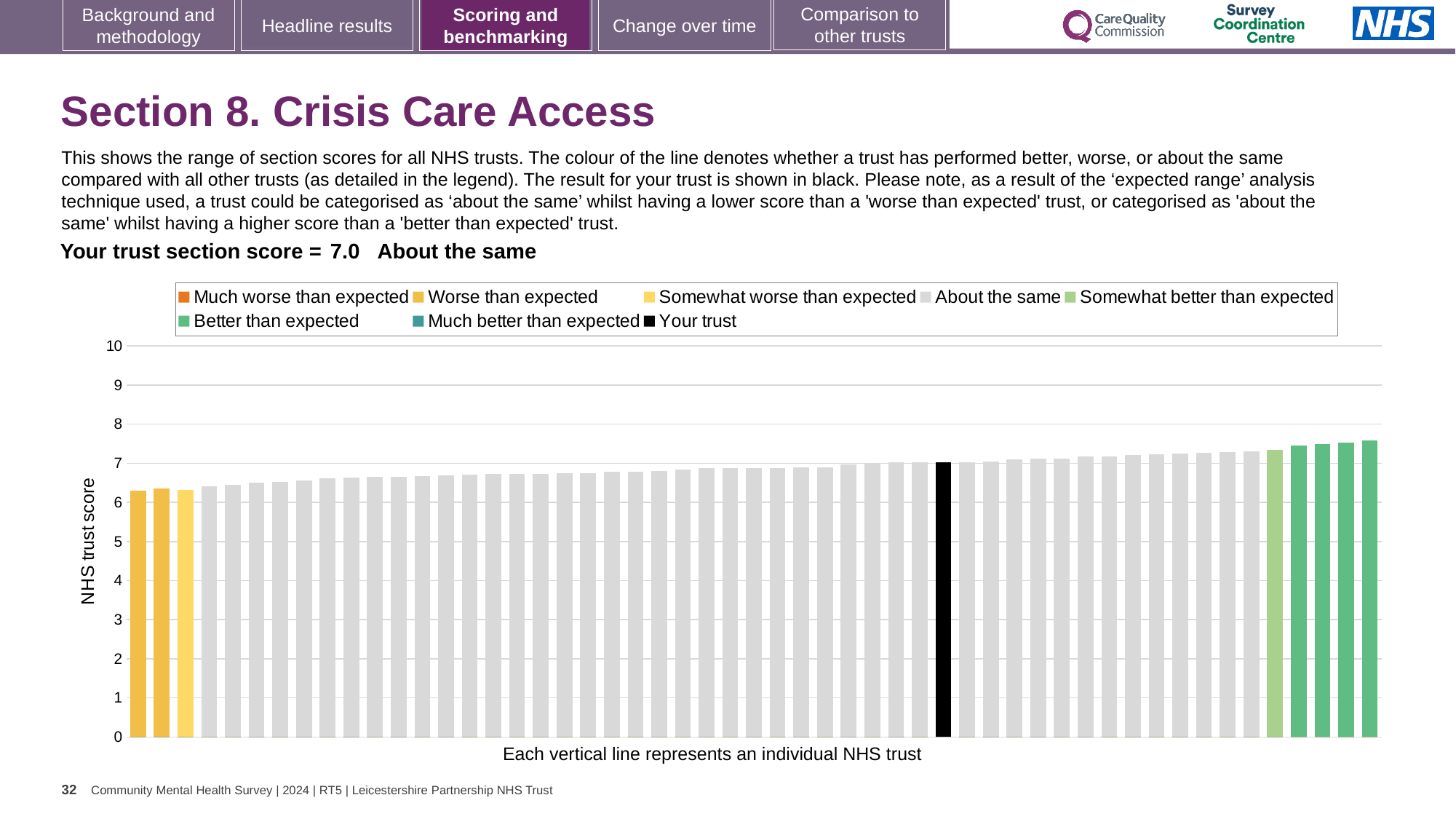
Is the value of the shortest bar greater or less than 7? less What is the section score for your trust shown on the slide? 7.0 How many bars are coloured as 'Worse than expected' (yellow)? 2 Is the value of the tallest bar greater or less than 8? less Is the value of the tallest bar greater or less than 7? greater How many bars are coloured as 'Better than expected' (green)? 4 What is the label on the vertical axis of the chart? NHS trust score Do the bar values rise or fall from left to right along the x axis? rise How many entries does the chart legend list? 8 What kind of chart is shown on the slide? bar chart Which is larger: the value of the black bar for your trust or the value of the leftmost yellow bar? the black bar for your trust